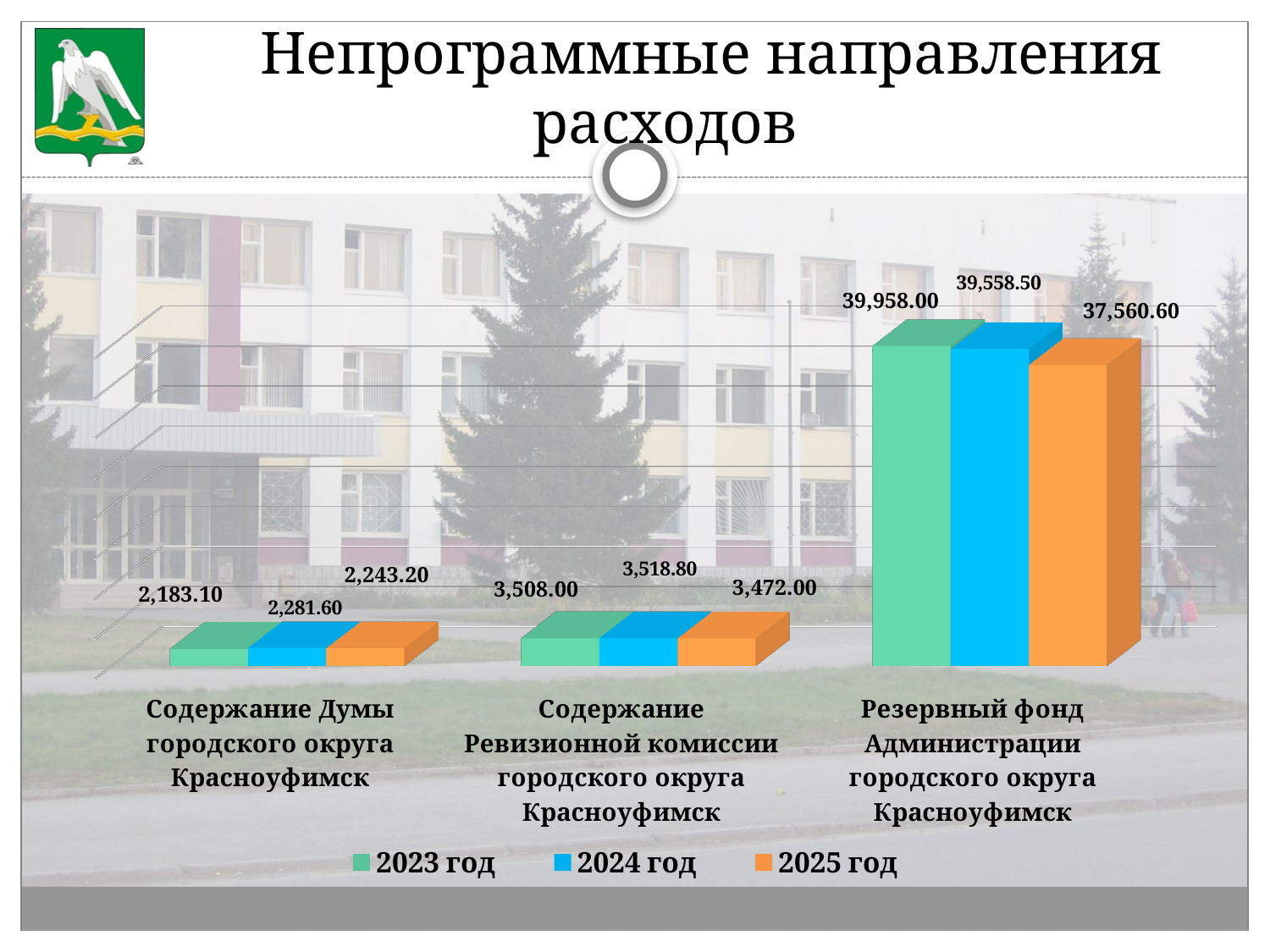
What kind of chart is shown on the slide? Bar chart What is the value for Содержание Ревизионной комиссии городского округа Красноуфимск in the 2024 год series? 3,518.80 What is the title of the chart on the slide? Непрограммные направления расходов How many series does the legend list? 3 What is the value for Резервный фонд Администрации городского округа Красноуфимск in the 2023 год series? 39,958.00 Which category has the lowest value in the 2025 год series? Содержание Думы городского округа Красноуфимск What is the value for Содержание Думы городского округа Красноуфимск in the 2023 год series? 2,183.10 Which category has the highest value in the 2024 год series? Резервный фонд Администрации городского округа Красноуфимск What is the difference between the 2023 год and 2025 год values for Резервный фонд Администрации городского округа Красноуфимск? 2,397.40 What is the value for Резервный фонд Администрации городского округа Красноуфимск in the 2025 год series? 37,560.60 Which is larger for Содержание Думы городского округа Красноуфимск: the 2023 год value or the 2024 год value? 2024 год How many categories are shown on the x axis of the chart? 3